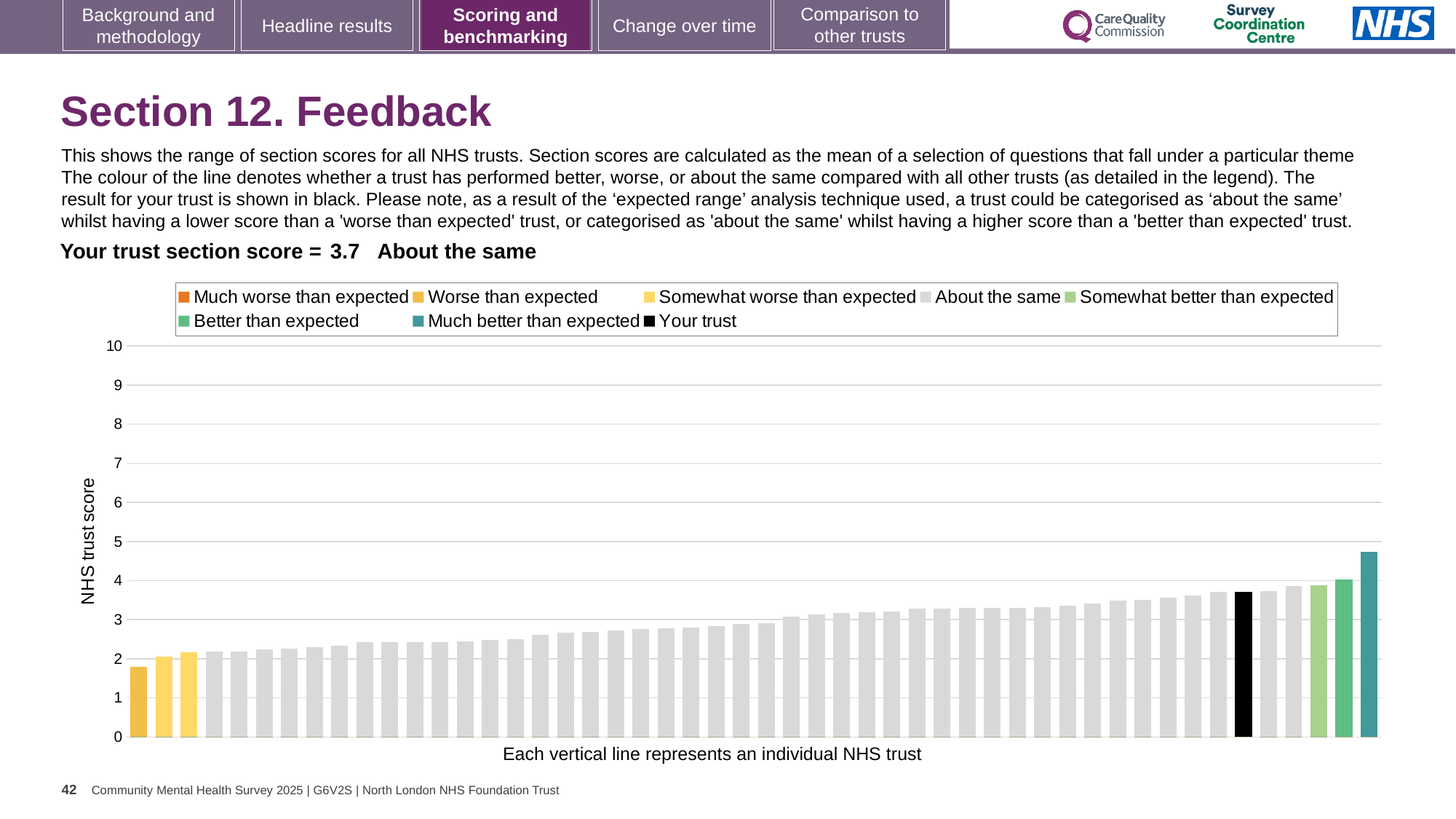
How many bars are coloured in the green shades (better than expected categories)? 3 What is the section score for your trust shown on the chart? 3.7 Is the value of the tallest bar (the 'Much better than expected' trust) greater or less than 4? greater Which legend category does the shortest bar belong to? Worse than expected Which legend category does the tallest bar belong to? Much better than expected How many bars are coloured in the yellow shades (worse than expected categories)? 3 How many entries does the chart legend list? 8 What is the title of the y axis? NHS trust score Do the bar values rise or fall from left to right along the x axis? rise What kind of chart is shown on the slide? bar chart What colour is the bar representing your trust? black Is the value of the shortest bar on the far left greater or less than 2? less